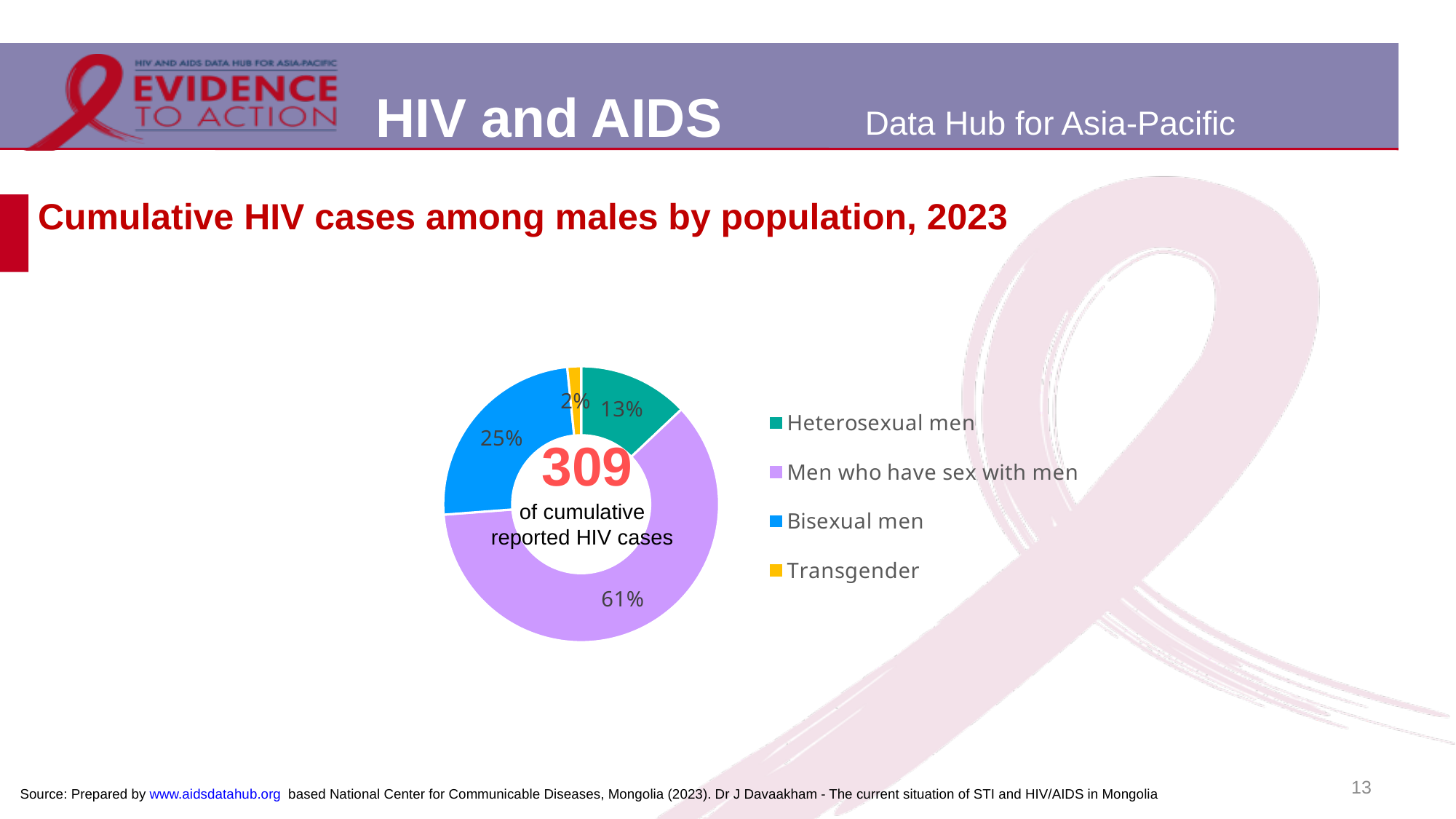
What share of cumulative HIV cases among males is attributed to transgender people? 2% Which population accounts for the smallest share of cumulative HIV cases among males? Transgender How many population categories does the chart show? 4 What total number of cumulative reported HIV cases is shown in the centre of the chart? 309 Which population accounts for the largest share of cumulative HIV cases among males? Men who have sex with men What share of cumulative HIV cases among males is attributed to bisexual men? 25% What share of cumulative HIV cases among males is attributed to men who have sex with men? 61% What kind of chart is used to show cumulative HIV cases among males by population? Doughnut (pie) chart What share of cumulative HIV cases among males is attributed to heterosexual men? 13% What colour represents bisexual men in the chart? Blue Which has a larger share of cumulative HIV cases among males: heterosexual men or bisexual men? Bisexual men What is the difference in percentage points between the share for men who have sex with men and the share for bisexual men? 36 percentage points